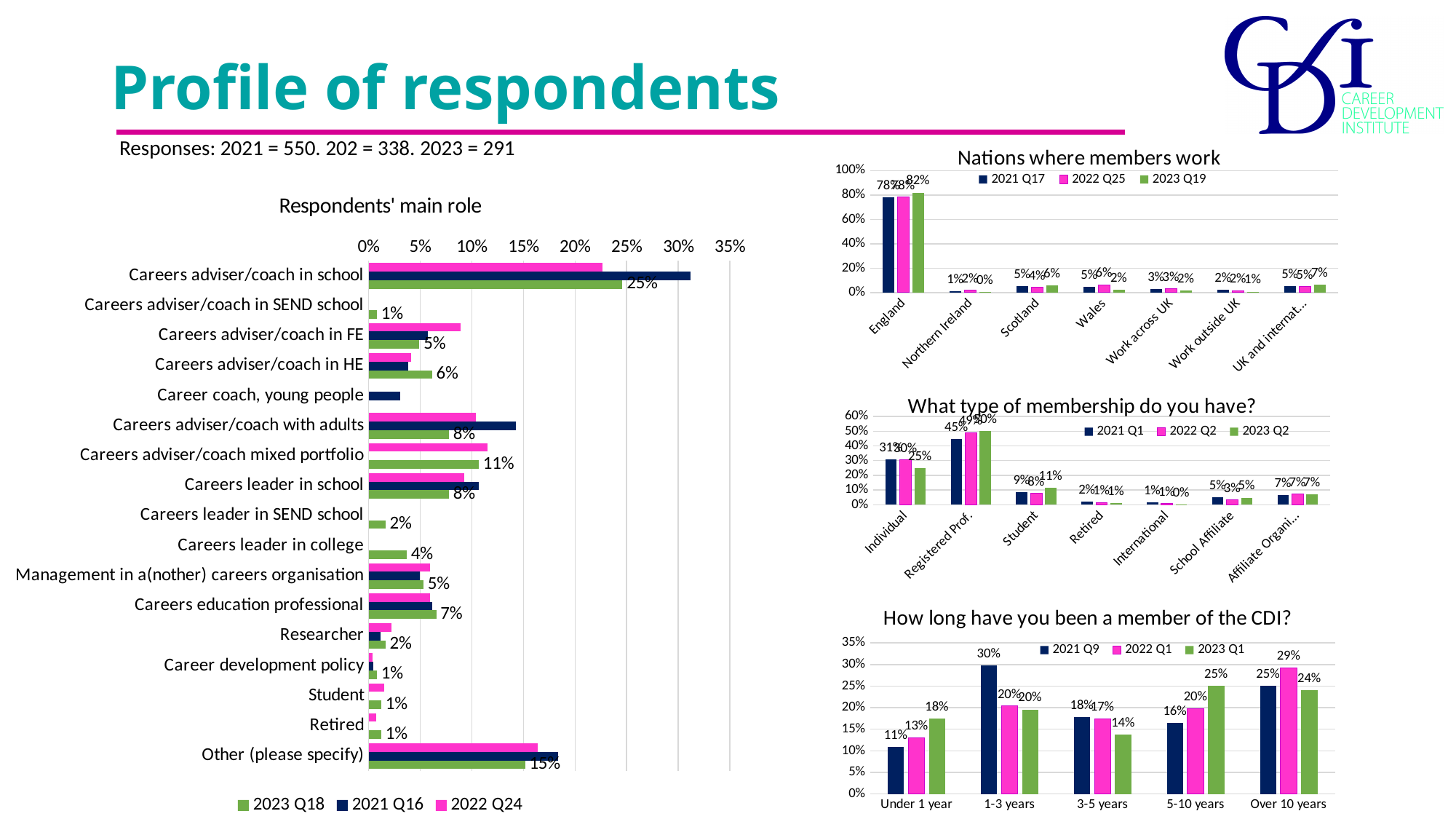
In the 'What type of membership do you have?' chart, which is larger for 2021 Q1: Individual or Student? Individual In the 'What type of membership do you have?' chart, what is the 2023 Q2 value for Registered Prof.? 50% In the 'Respondents' main role' chart, what is the 2023 Q18 value for Other (please specify)? 15% In the 'Respondents' main role' chart, is the 2021 Q16 value for Careers adviser/coach in school greater or less than 30%? greater In the 'How long have you been a member of the CDI?' chart, what is the 2021 Q9 value for 1-3 years? 30% In the 'How long have you been a member of the CDI?' chart, what is the 2023 Q1 value for 5-10 years? 25% In the 'Nations where members work' chart, what is the 2023 Q19 value for England? 82% In the 'Nations where members work' chart, how many series does the legend list? 3 In the 'How long have you been a member of the CDI?' chart, what is the difference between the 2023 Q1 and 2021 Q9 values for Under 1 year? 7% In the 'Nations where members work' chart, which nation has the highest values? England What kind of chart is 'Respondents' main role'? Bar chart In the 'How long have you been a member of the CDI?' chart, how many categories are shown on the x axis? 5